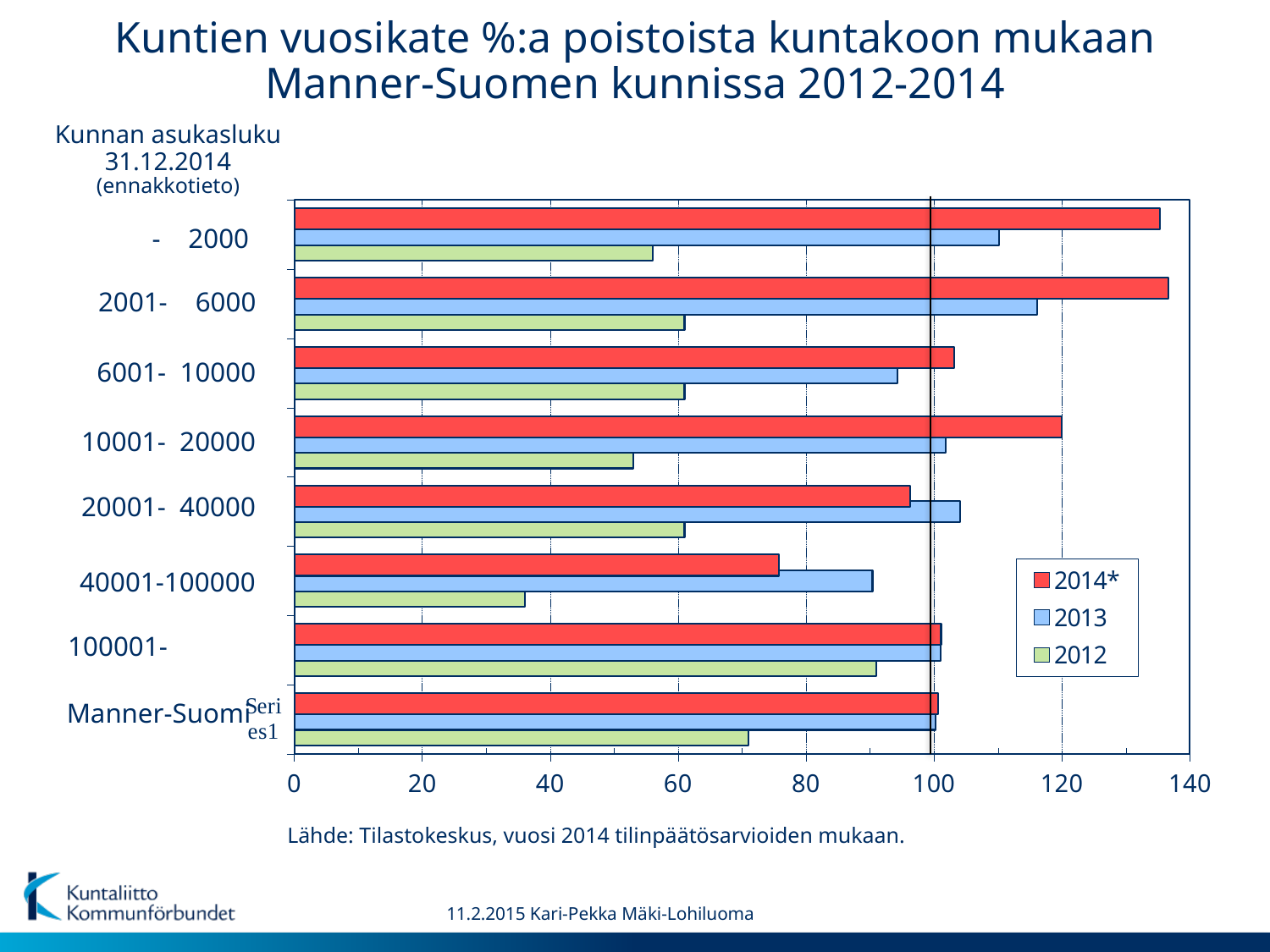
Is the 2012 value for the '40001-100000' category greater or less than 40? less Which category has the lowest 2014* value? 40001-100000 How many series does the legend list? 3 Which category has the lowest 2012 value? 40001-100000 Is the 2014* value for the '- 2000' category greater or less than 120? greater How many municipality size categories are shown on the vertical axis of the chart? 8 For the '40001-100000' category, which is larger: the 2013 value or the 2014* value? 2013 What kind of chart is shown on the slide? bar chart Which category has the highest 2012 value? 100001- Which series is shown in red in the legend? 2014* Is the 2014* value for the '40001-100000' category greater or less than 80? less